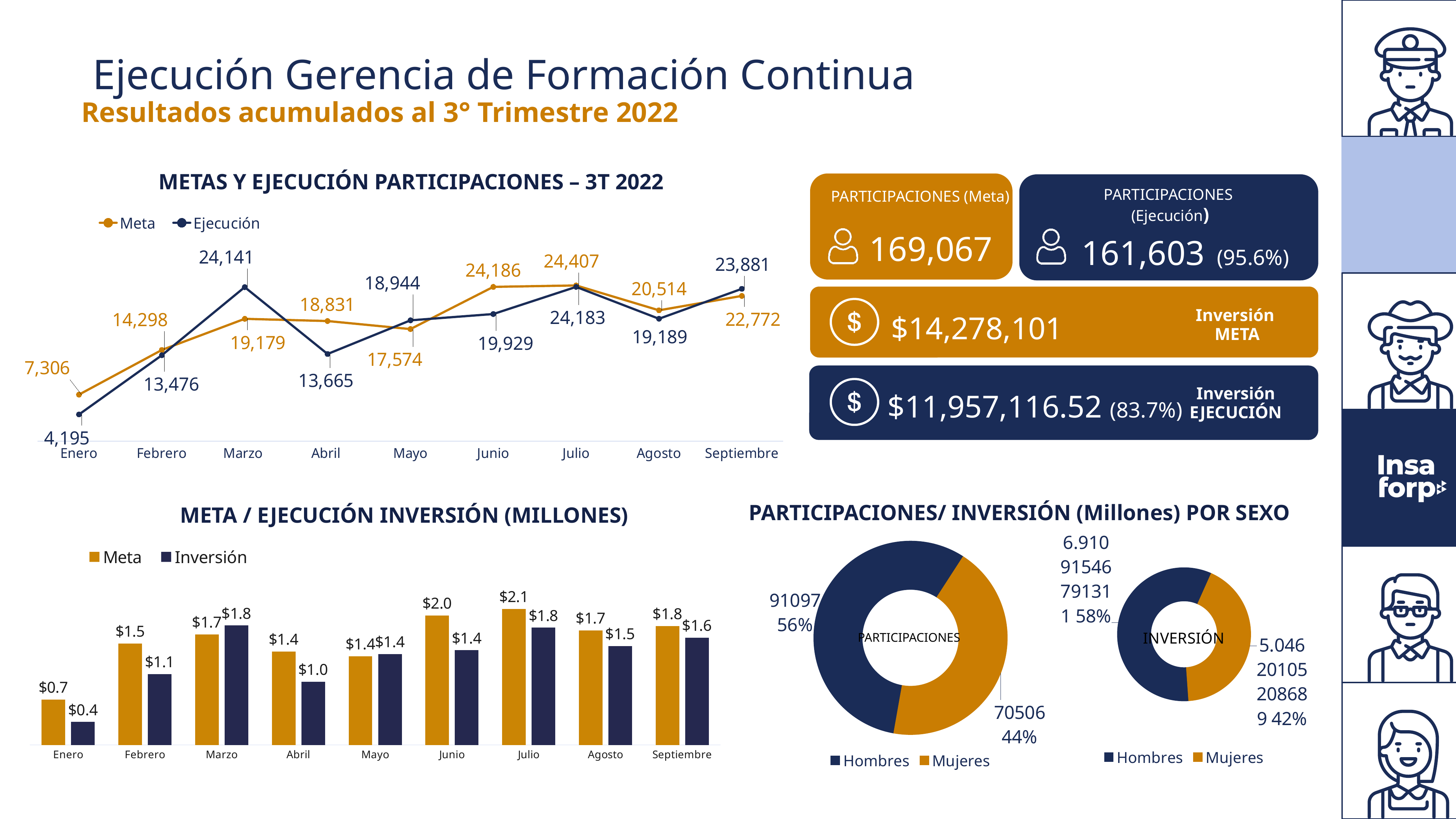
In the line chart 'METAS Y EJECUCIÓN PARTICIPACIONES – 3T 2022', what is the Meta value for Junio? 24,186 What kind of chart is 'META / EJECUCIÓN INVERSIÓN (MILLONES)'? bar chart In the bar chart 'META / EJECUCIÓN INVERSIÓN (MILLONES)', which month has the highest Meta value? Julio In the bar chart 'META / EJECUCIÓN INVERSIÓN (MILLONES)', what is the Inversión value for Abril? $1.0 In the donut chart labelled 'PARTICIPACIONES' (bottom right), what share of participations corresponds to Hombres? 56% In the donut chart labelled 'PARTICIPACIONES' (bottom right), what is the value for Mujeres? 70506 In the line chart 'METAS Y EJECUCIÓN PARTICIPACIONES – 3T 2022', how many months are shown on the x axis? 9 In the line chart 'METAS Y EJECUCIÓN PARTICIPACIONES – 3T 2022', which month has the lowest Ejecución value? Enero In the bar chart 'META / EJECUCIÓN INVERSIÓN (MILLONES)', what is the Meta value for Julio? $2.1 In the line chart 'METAS Y EJECUCIÓN PARTICIPACIONES – 3T 2022', what is the Ejecución value for Marzo? 24,141 In the line chart 'METAS Y EJECUCIÓN PARTICIPACIONES – 3T 2022', what is the difference between the Meta and Ejecución values for Enero? 3,111 In the line chart 'METAS Y EJECUCIÓN PARTICIPACIONES – 3T 2022', how many series does the legend list? 2